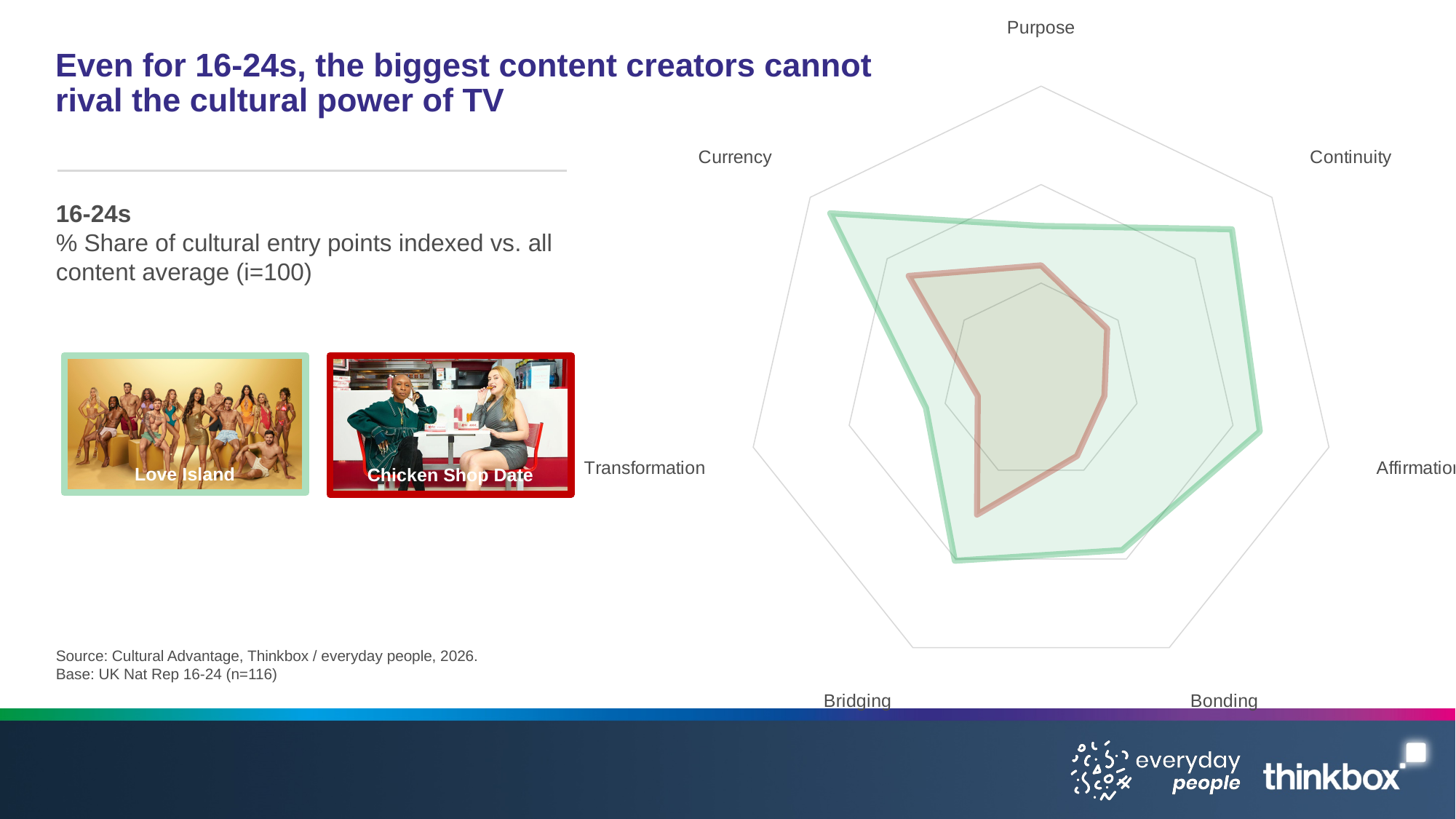
On the Affirmation axis, which series has the larger value, Love Island or Chicken Shop Date? Love Island Which series is plotted in red on the radar chart? Chicken Shop Date Which axis label appears at the top of the radar chart? Purpose How many series are plotted on the radar chart? 2 Which series covers the larger area on the radar chart? Love Island Which series is plotted in green on the radar chart? Love Island What kind of chart is shown on the slide? Radar chart On the Currency axis, which series has the larger value, Love Island or Chicken Shop Date? Love Island How many axes (cultural entry points) does the radar chart have? 7 On which axis does Love Island have its lowest value? Transformation